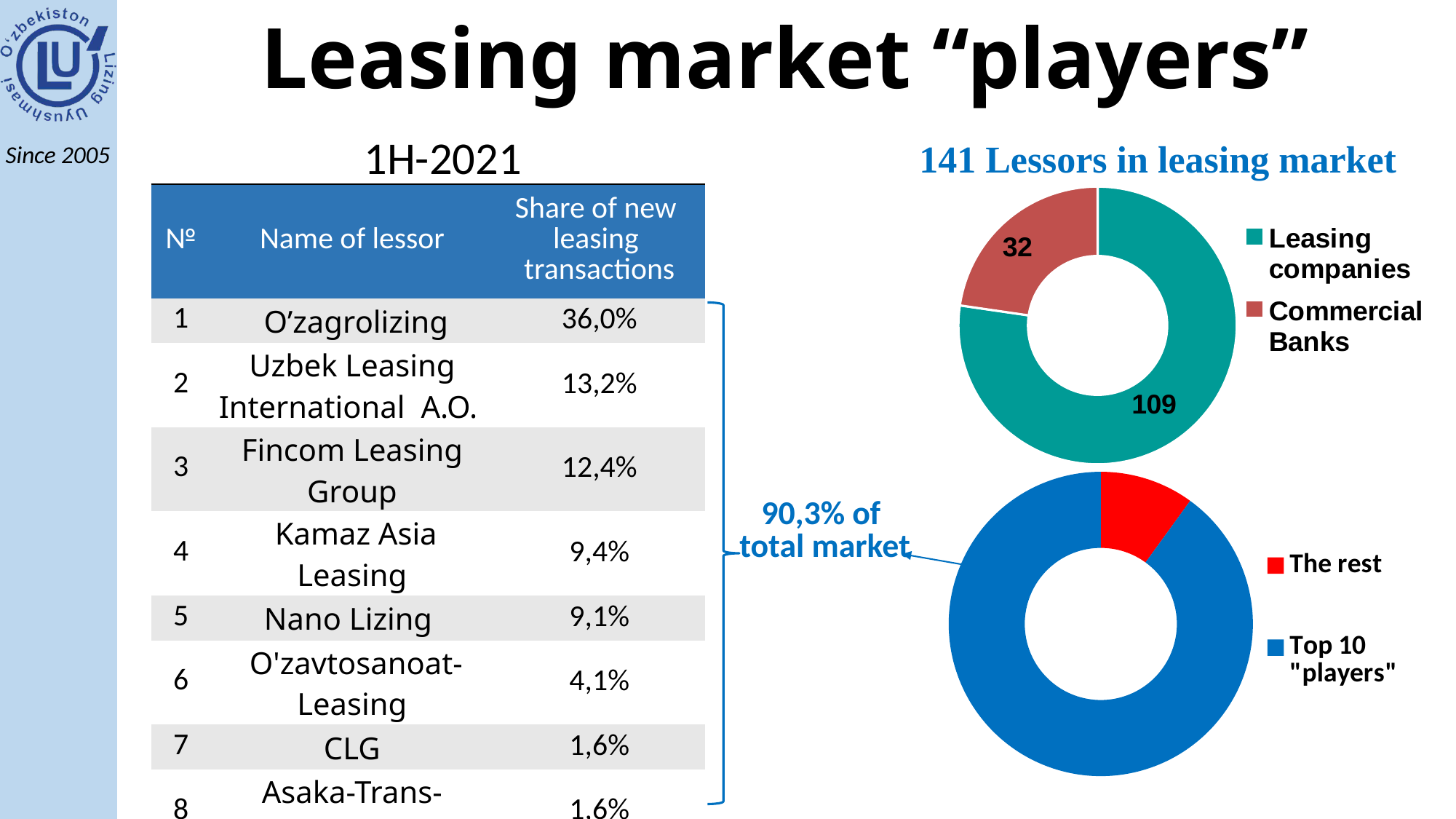
In the chart titled "141 Lessors in leasing market", which category has the smaller number of lessors? Commercial Banks In the bottom-right chart, what colour represents "The rest"? Red How many categories does the legend of the chart titled "141 Lessors in leasing market" list? 2 In the chart titled "141 Lessors in leasing market", which category has the larger number of lessors? Leasing companies In the chart titled "141 Lessors in leasing market", how many lessors are commercial banks? 32 What type of chart is the chart titled "141 Lessors in leasing market"? Doughnut chart In the bottom-right chart, what share of the total market do the Top 10 "players" hold, according to the annotation? 90,3% In the chart titled "141 Lessors in leasing market", how many lessors are leasing companies? 109 In the bottom-right chart, which category takes the larger share: "The rest" or "Top 10 "players""? Top 10 "players" In the chart titled "141 Lessors in leasing market", what is the total number of lessors across both categories? 141 In the chart titled "141 Lessors in leasing market", what is the difference between the number of leasing companies and the number of commercial banks? 77 In the chart titled "141 Lessors in leasing market", what colour represents Commercial Banks? Red